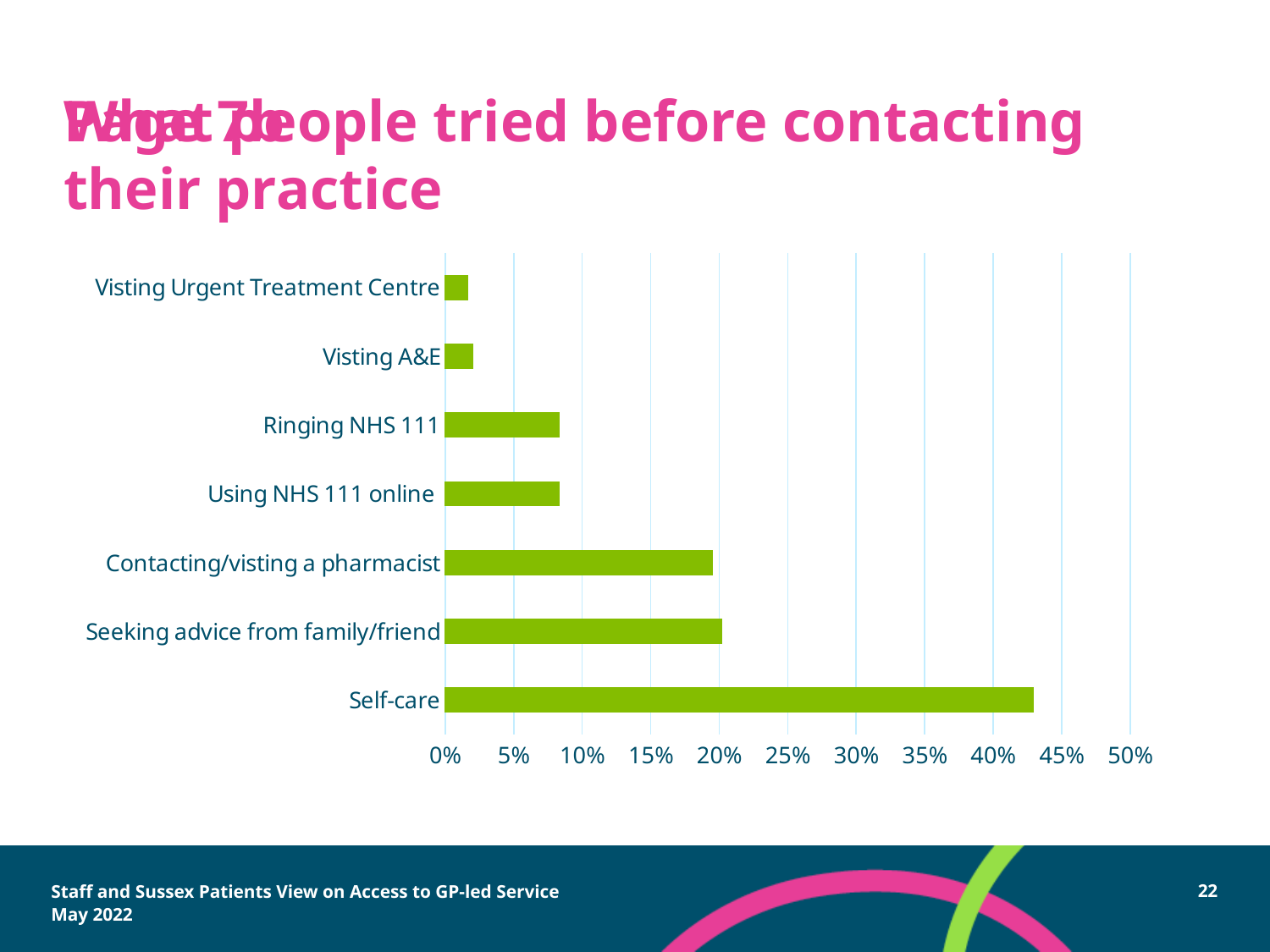
Is the value for Seeking advice from family/friend greater or less than 15%? greater How many categories are plotted in the chart? 7 Is the value for Self-care greater or less than 40%? greater What is the highest value shown on the horizontal axis of the chart? 50% Is the value for Contacting/visiting a pharmacist greater or less than 25%? less Which category has the highest value in the chart? Self-care Which is larger, the value for Self-care or the value for Contacting/visiting a pharmacist? Self-care What kind of chart is shown on the slide? bar chart